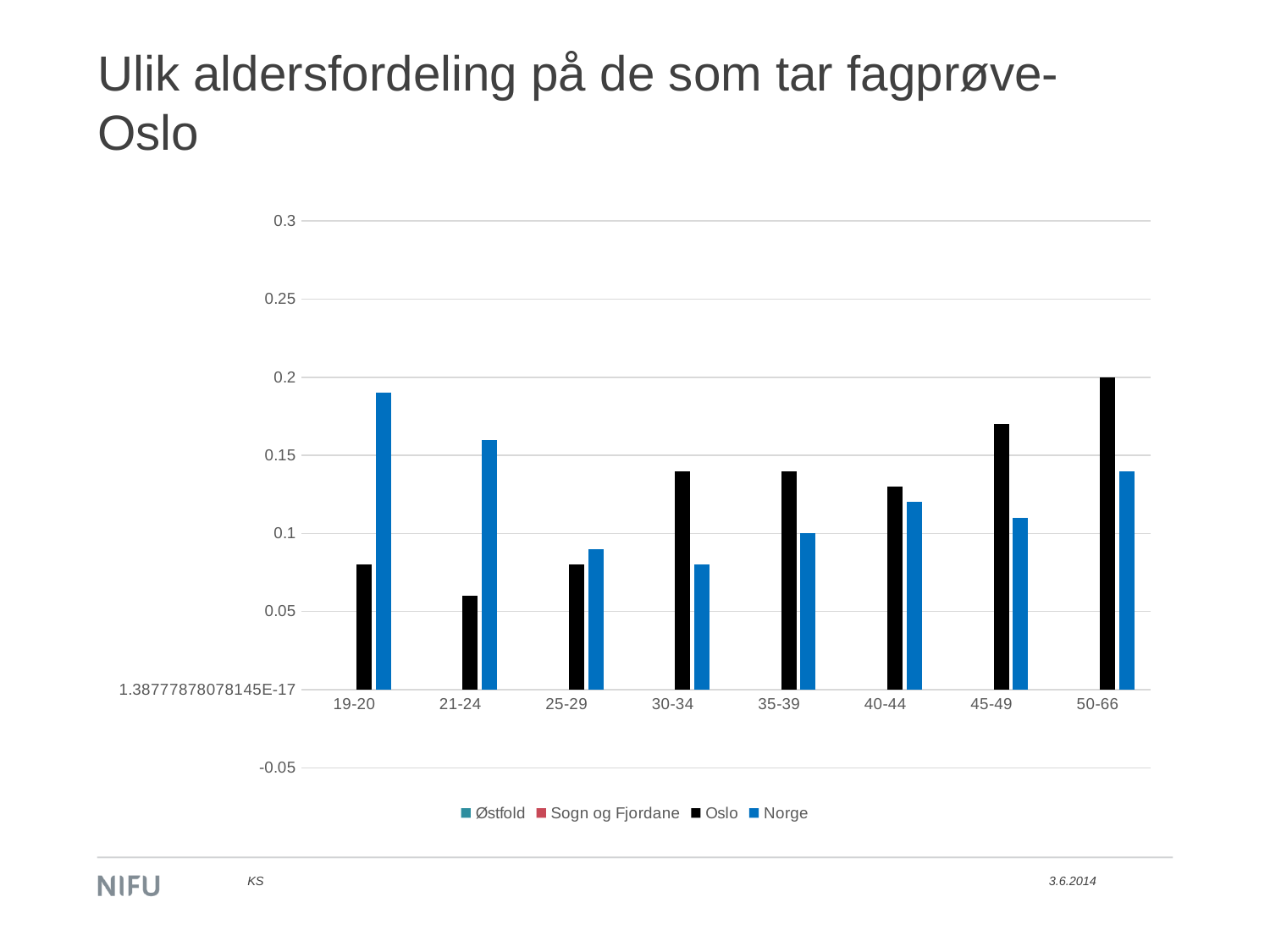
Is the Oslo value for 21-24 greater or less than 0.1? less In the 50-66 age group, which is larger, Oslo or Norge? Oslo For which age group is the Norge value highest? 19-20 Which series are listed in the legend? Østfold, Sogn og Fjordane, Oslo, Norge How many series does the legend list? 4 Is the Norge value for 19-20 greater or less than 0.15? greater Is the Oslo value for 45-49 greater or less than 0.15? greater For which age group is the Oslo value lowest? 21-24 For which age group is the Oslo value highest? 50-66 What kind of chart is shown on the slide? bar chart In the 19-20 age group, which is larger, Oslo or Norge? Norge How many age-group categories are shown on the x axis? 8